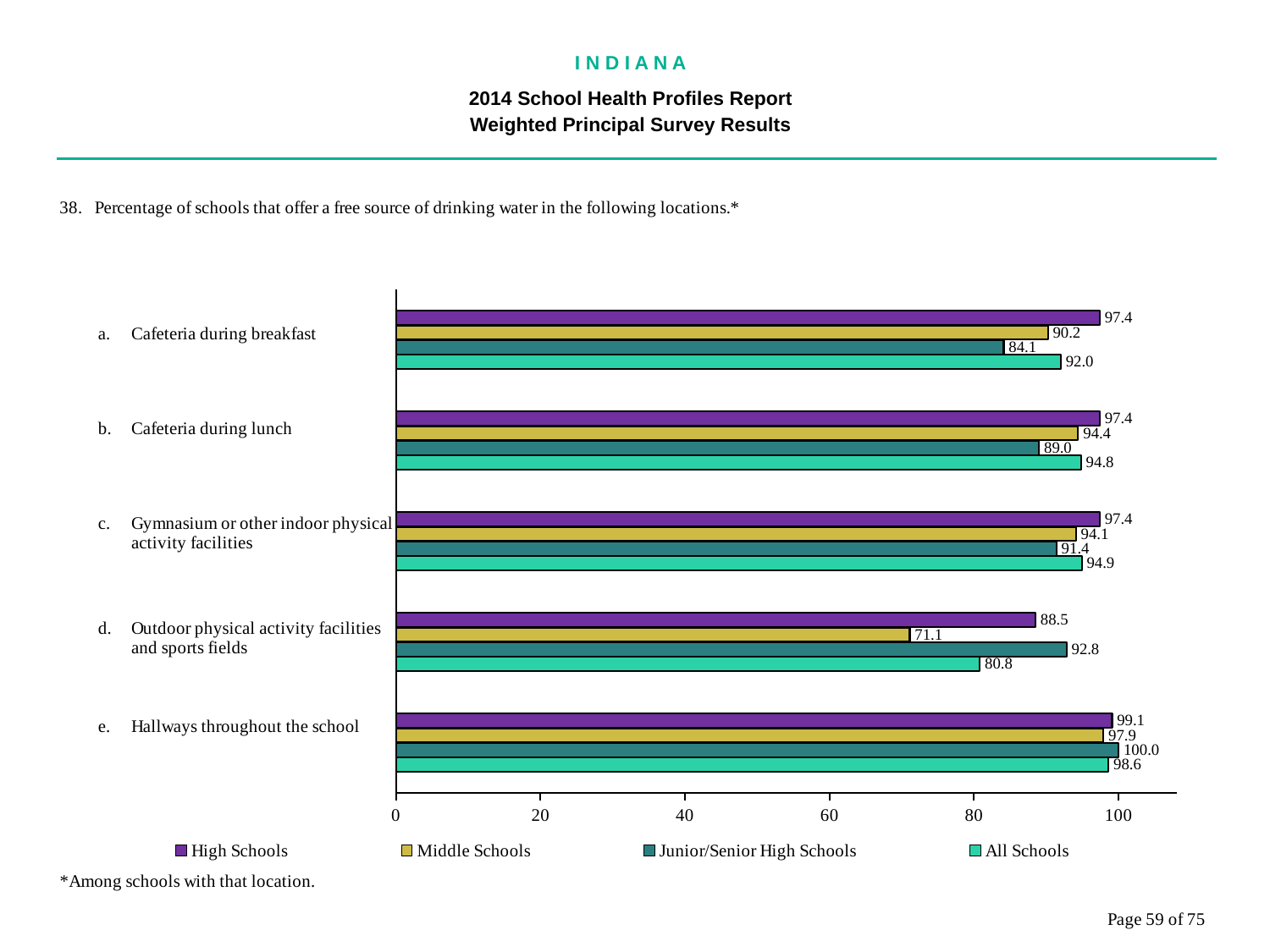
What is the value for Junior/Senior High Schools for 'Hallways throughout the school'? 100.0 How many series does the legend list? 4 What is the value for High Schools for 'Cafeteria during breakfast'? 97.4 What is the value for Middle Schools for 'Outdoor physical activity facilities and sports fields'? 71.1 Which location has the highest value for All Schools? Hallways throughout the school Which series is shown in the legend immediately after 'Middle Schools'? Junior/Senior High Schools For 'Cafeteria during breakfast', which is larger: the Middle Schools value or the Junior/Senior High Schools value? Middle Schools What is the difference between the High Schools and Middle Schools values for 'Outdoor physical activity facilities and sports fields'? 17.4 How many locations (categories) are shown in the chart? 5 What kind of chart is shown on the slide? Bar chart Which location has the lowest value for Middle Schools? Outdoor physical activity facilities and sports fields What is the value for All Schools for 'Cafeteria during lunch'? 94.8